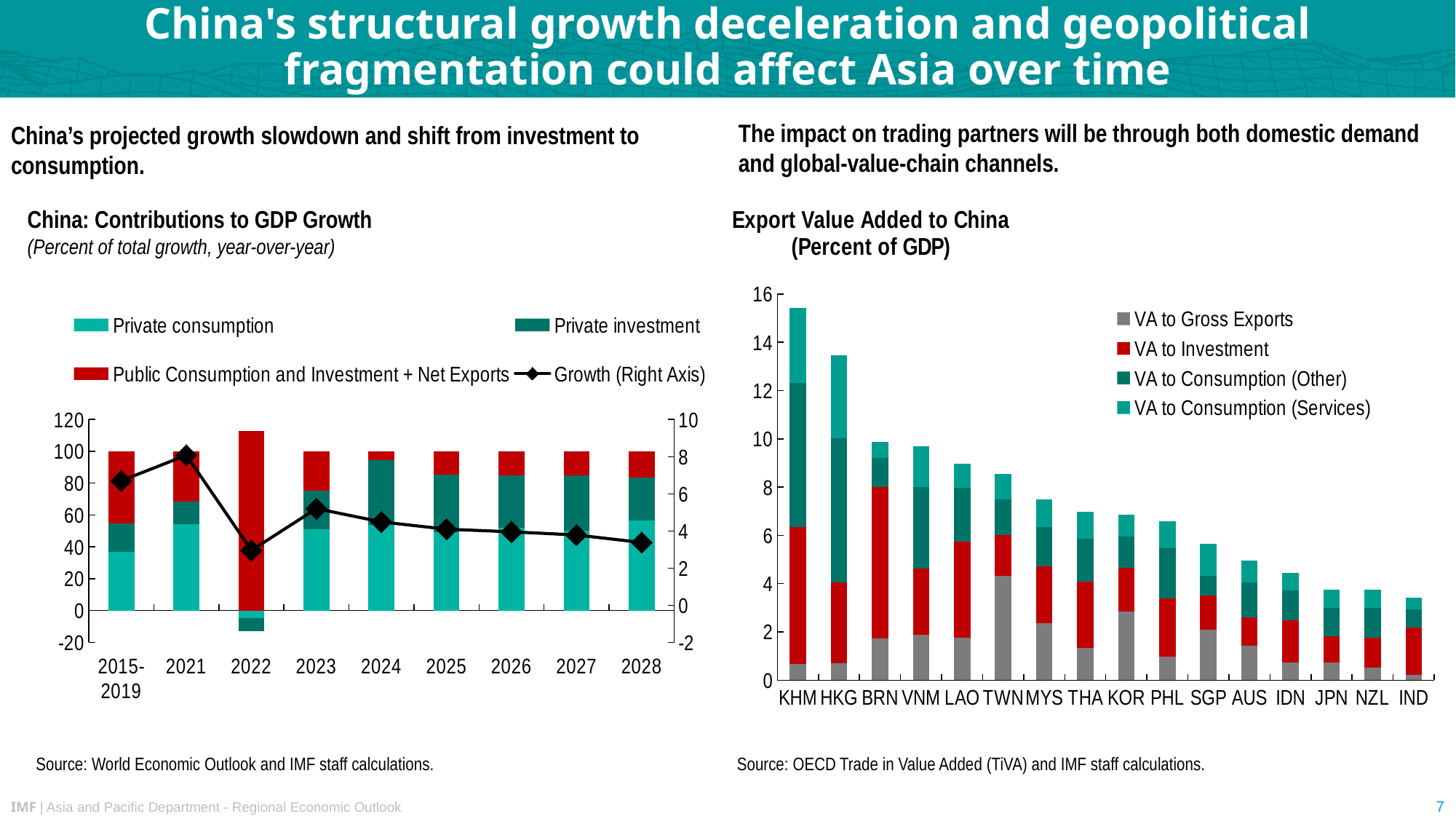
How many countries are shown on the x axis of the 'Export Value Added to China' chart? 16 In the 'Export Value Added to China' chart, is the total value for IND greater or less than 4? less In the 'China: Contributions to GDP Growth' chart, is the Growth (Right Axis) value for 2022 greater or less than 4? less What kind of chart is the 'Export Value Added to China' chart on the right? stacked bar chart In the 'Export Value Added to China' chart, is the total value for KHM greater or less than 14? greater In the 'Export Value Added to China' chart, which country has the highest total bar? KHM In the 'Export Value Added to China' chart, which has the larger total bar, TWN or MYS? TWN In the 'China: Contributions to GDP Growth' chart, in which year does the Growth (Right Axis) line reach its highest point? 2021 In the 'Export Value Added to China' chart, which country has the lowest total bar? IND How many series does the legend of the 'Export Value Added to China' chart list? 4 How many time periods are shown on the x axis of the 'China: Contributions to GDP Growth' chart? 9 In the 'Export Value Added to China' chart, do the total bar heights rise or fall from left to right along the x axis? fall